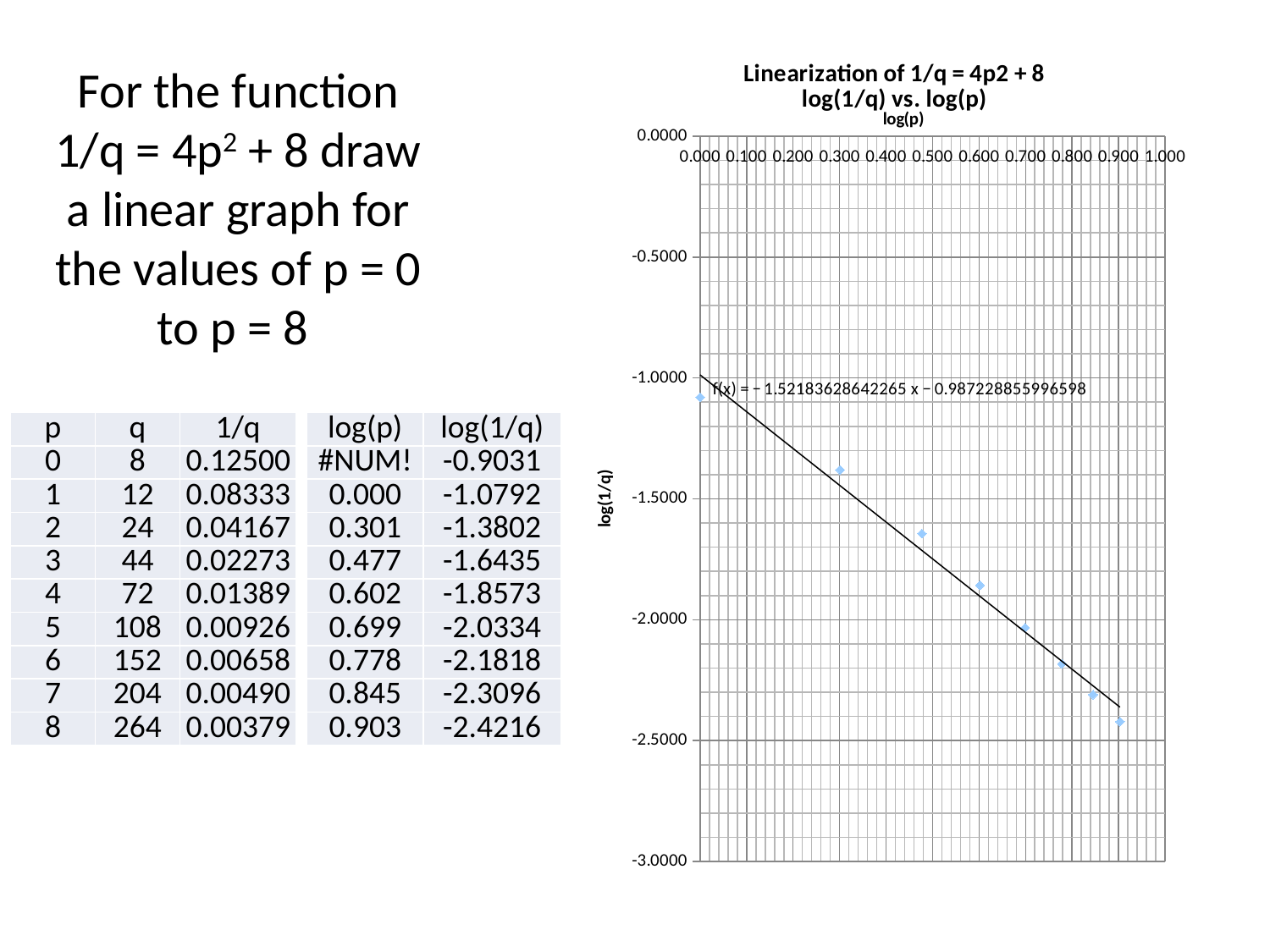
At which value of log(p) is the plotted log(1/q) highest? 0.000 Which plotted point has the larger log(1/q) value: the one at log(p) = 0.477 or the one at log(p) = 0.778? log(p) = 0.477 What is the title of the chart? Linearization of 1/q = 4p2 + 8 log(1/q) vs. log(p) Using the table values, what is the difference between the log(1/q) values at log(p) = 0.000 and log(p) = 0.903? 1.3424 Is the plotted value of log(1/q) at log(p) = 0.903 greater or less than -2.0000? less At which value of log(p) is the plotted log(1/q) lowest? 0.903 What kind of chart is shown on the slide? scatter chart According to the table, what is the value of log(1/q) plotted at log(p) = 0.301? -1.3802 Is the plotted value of log(1/q) at log(p) = 0.000 greater or less than -1.5000? greater What is the label of the vertical axis of the chart? log(1/q) Do the plotted log(1/q) values rise or fall as log(p) increases? fall How many data points are plotted on the chart? 8